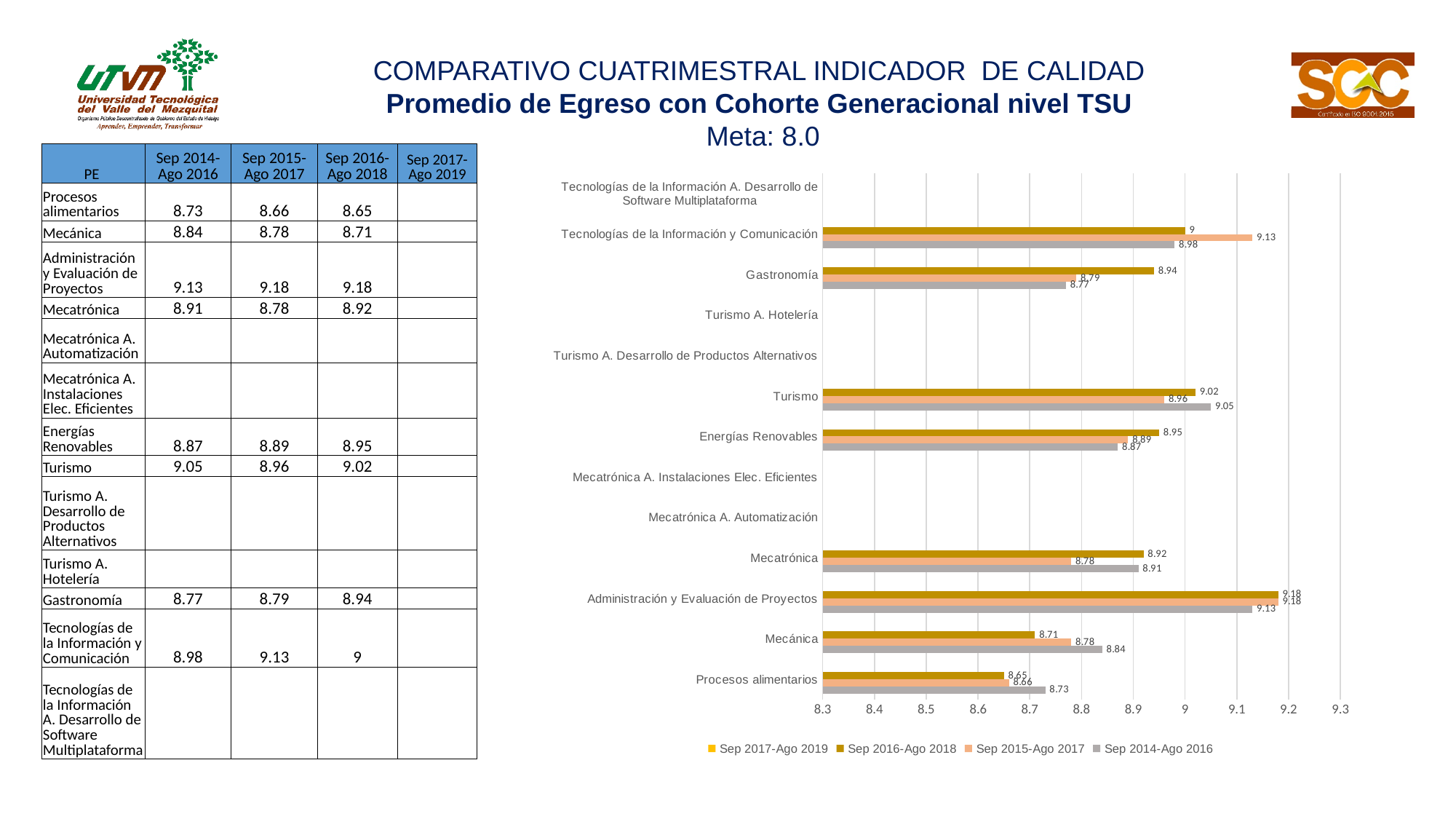
What is the value for Gastronomía in the Sep 2016-Ago 2018 series? 8.94 What is the value for Mecánica in the Sep 2014-Ago 2016 series? 8.84 Which category has the lowest value in the Sep 2016-Ago 2018 series? Procesos alimentarios What is the difference between the Sep 2014-Ago 2016 and Sep 2016-Ago 2018 values for Mecánica? 0.13 How many categories are listed on the vertical axis of the chart? 13 What kind of chart is shown on the slide? bar chart For Turismo, which series has the larger value: Sep 2014-Ago 2016 or Sep 2016-Ago 2018? Sep 2014-Ago 2016 How many series does the chart legend list? 4 Do the values for Procesos alimentarios rise or fall from Sep 2014-Ago 2016 to Sep 2016-Ago 2018? fall Which category has the highest value in the Sep 2016-Ago 2018 series? Administración y Evaluación de Proyectos What is the value for Energías Renovables in the Sep 2015-Ago 2017 series? 8.89 Is the value for Tecnologías de la Información y Comunicación in the Sep 2015-Ago 2017 series greater or less than 9? greater